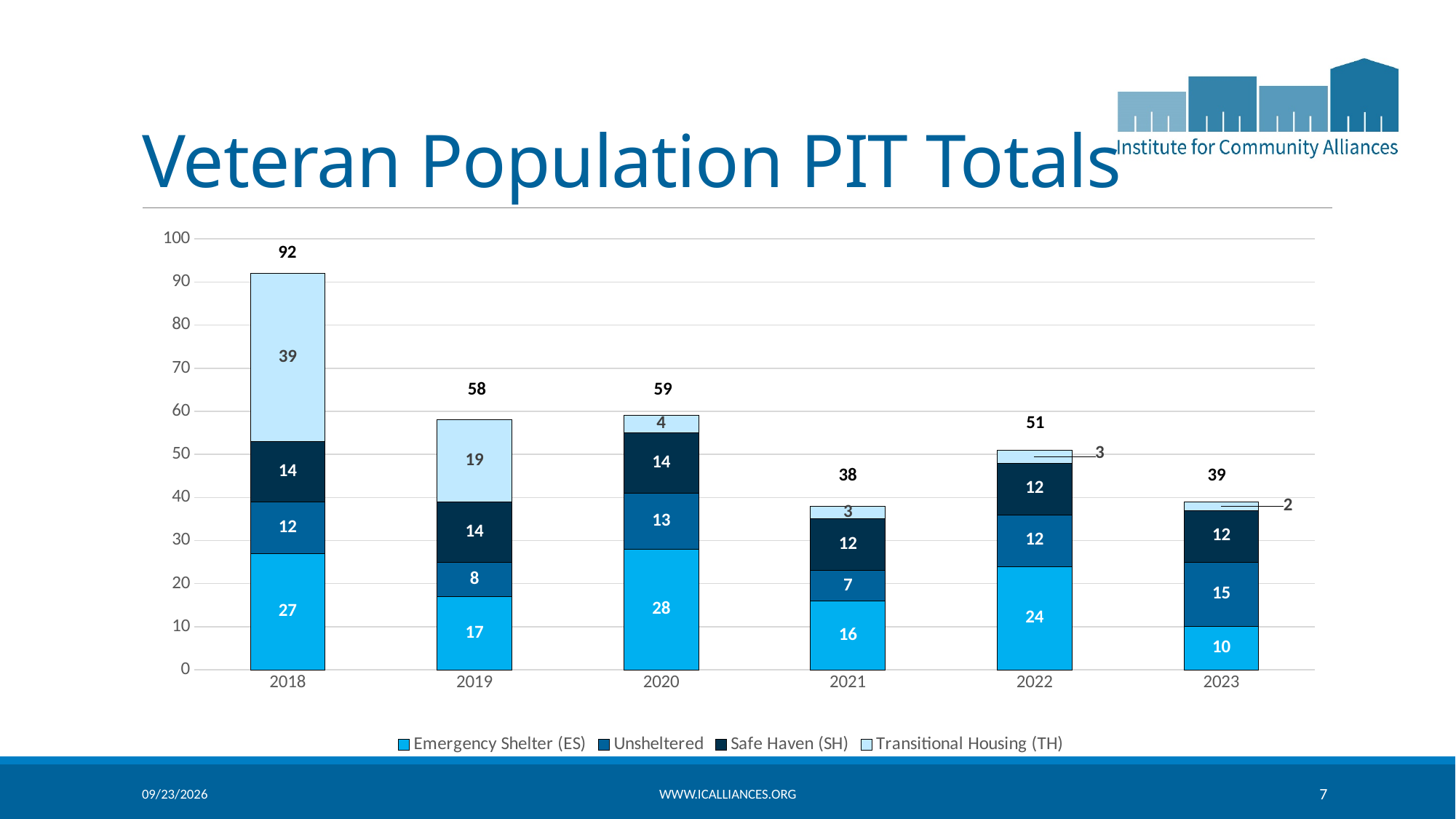
Which is larger, the Safe Haven (SH) value for 2019 or the Safe Haven (SH) value for 2021? 2019 Which year has the lowest total? 2021 What is the Transitional Housing (TH) value for 2018? 39 What type of chart is shown on the slide? Stacked bar chart What is the total of the stacked bar for 2022? 51 What is the title of the chart? Veteran Population PIT Totals Which year has the highest total? 2018 How many series does the legend list? 4 What is the Emergency Shelter (ES) value for 2020? 28 How many years are shown on the x axis? 6 What is the Unsheltered value for 2023? 15 What is the difference between the totals for 2018 and 2019? 34